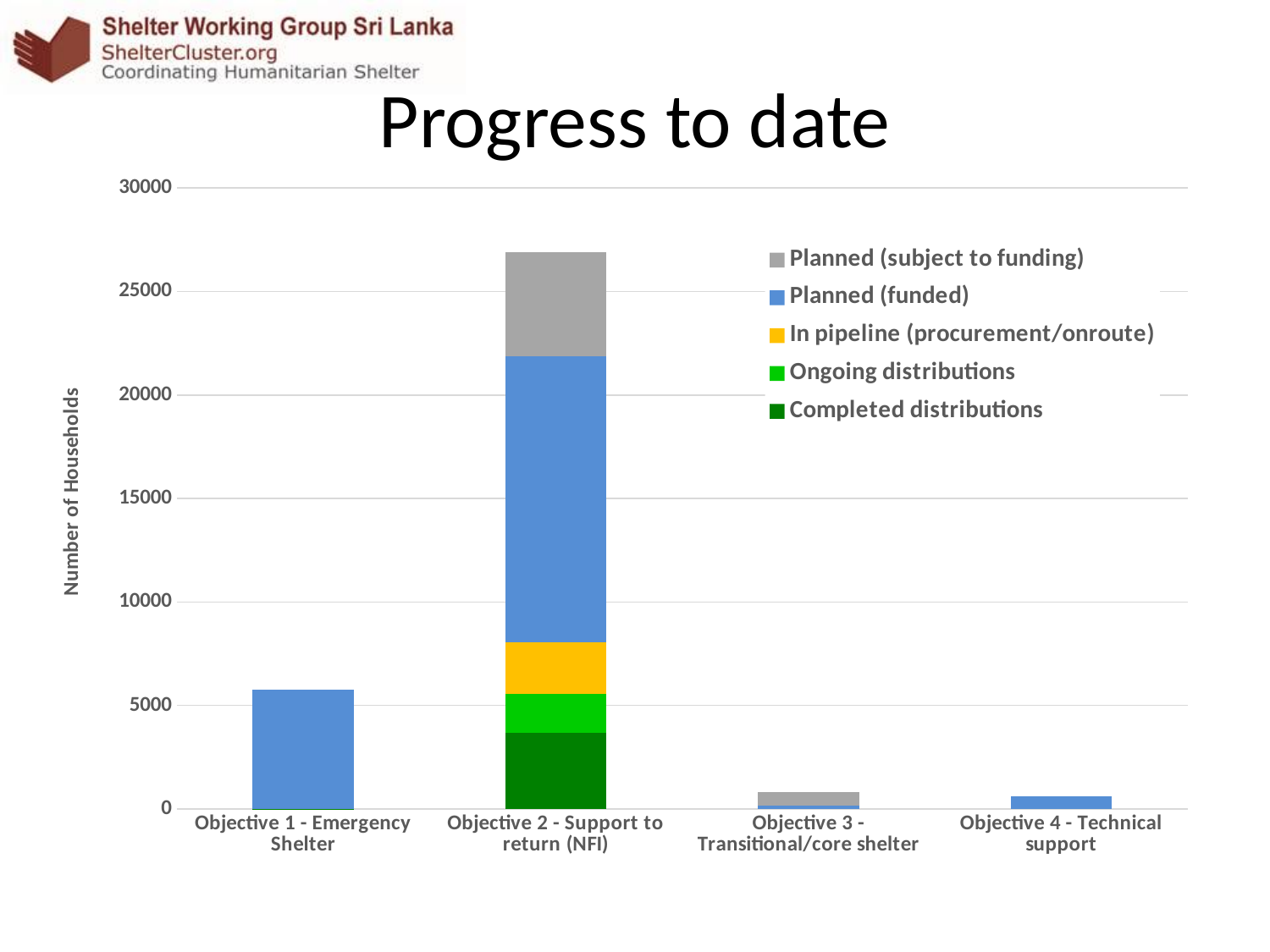
Which objective has the tallest stacked bar? Objective 2 - Support to return (NFI) Is the total for Objective 1 - Emergency Shelter greater or less than 5000? greater How many series does the legend list? 5 Is the total for Objective 2 - Support to return (NFI) greater or less than 25000? greater What is the label of the y axis? Number of Households How many objectives (categories) are shown along the x axis? 4 Is the total for Objective 3 - Transitional/core shelter greater or less than 5000? less Which series is shown in grey in the legend? Planned (subject to funding) Which has the larger total, Objective 1 - Emergency Shelter or Objective 2 - Support to return (NFI)? Objective 2 - Support to return (NFI) Which has the larger total, Objective 1 - Emergency Shelter or Objective 4 - Technical support? Objective 1 - Emergency Shelter What kind of chart is shown on the slide? Stacked bar chart